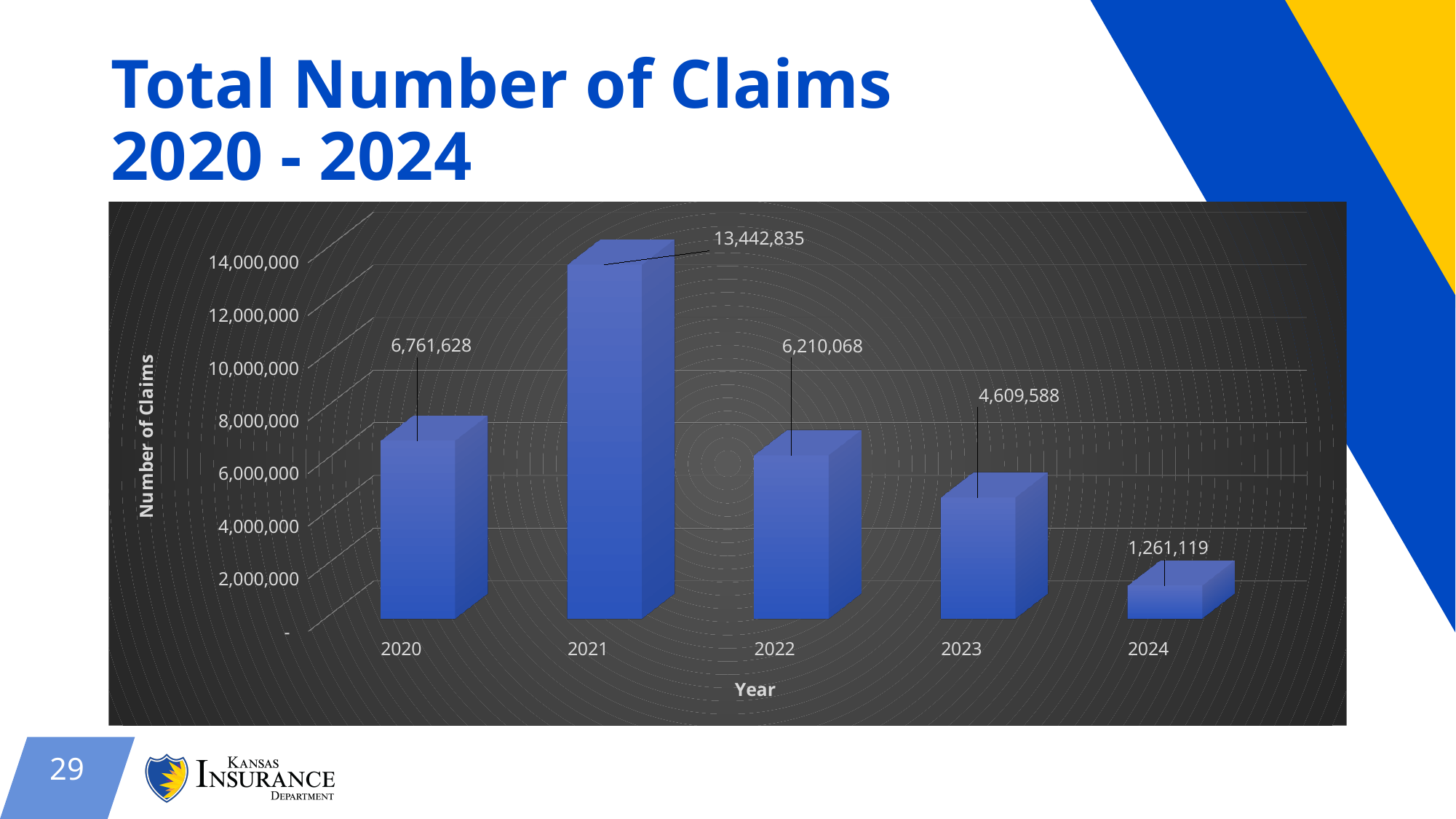
Is the number of claims for 2023 greater or less than 6,000,000? less What kind of chart is shown on the slide? bar chart What is the difference in the number of claims between 2020 and 2022? 551,560 What is the total number of claims for 2023? 4,609,588 What is the total number of claims for 2024? 1,261,119 What is the difference in the number of claims between 2021 and 2020? 6,681,207 Which year has more claims, 2022 or 2023? 2022 What is the total number of claims for 2021? 13,442,835 Which year has the lowest number of claims? 2024 Which year has the highest number of claims? 2021 How many years are shown on the x axis of the chart? 5 Do the number of claims rise or fall from 2021 to 2024? fall